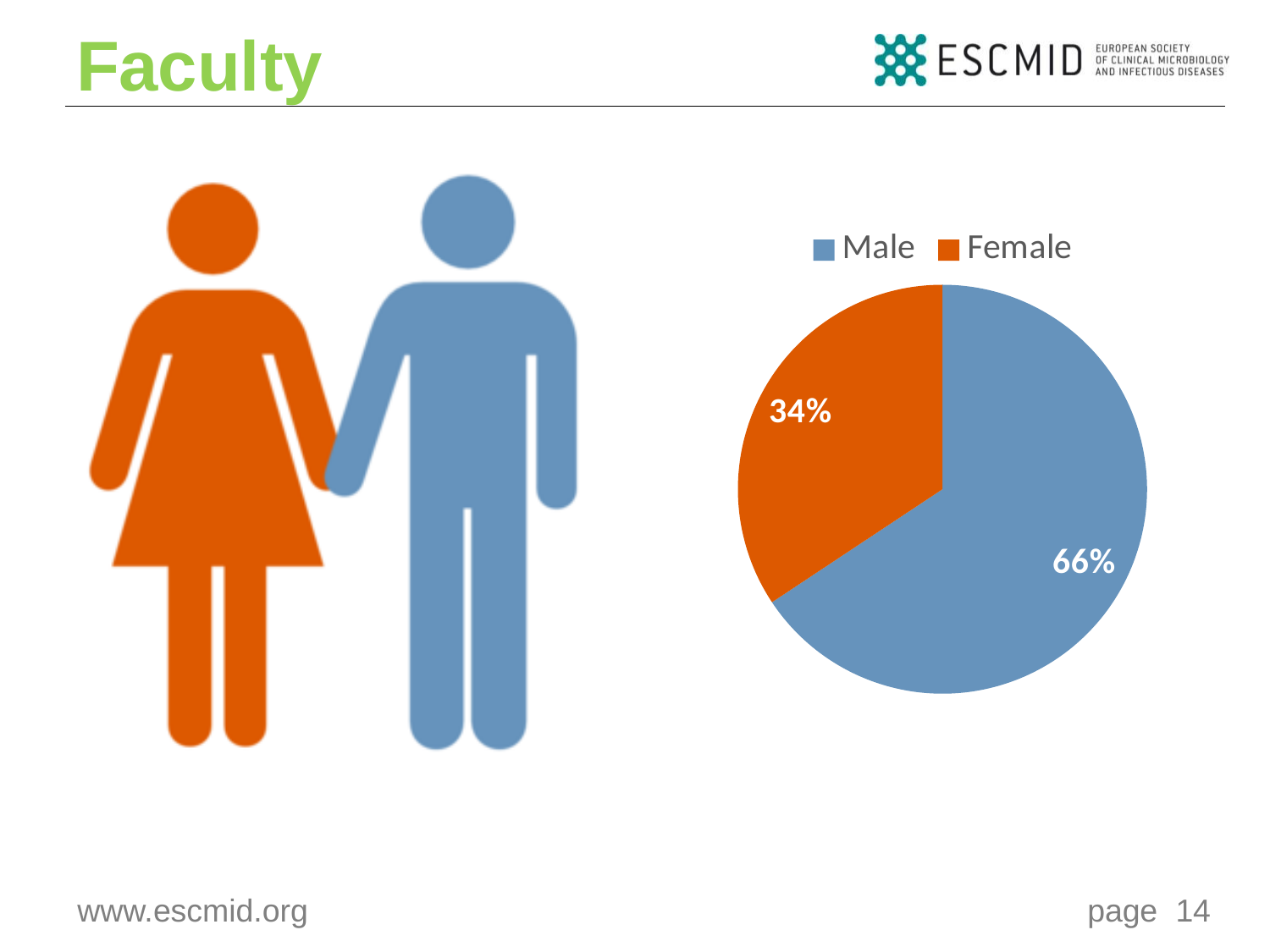
What is the share of the pie chart taken by the Male slice? 66% What percentage of the pie chart is Male? 66% What is the difference in percentage points between the Male and Female slices? 32 How many slices does the pie chart have? 2 Which category has the smallest share of the pie chart? Female What colour is the Male slice in the pie chart? blue Which slice is larger, Male or Female? Male What percentage of the pie chart is Female? 34% What kind of chart is shown on the slide? pie chart Which category has the largest share of the pie chart? Male How many entries does the legend list? 2 What colour is the Female slice in the pie chart? orange